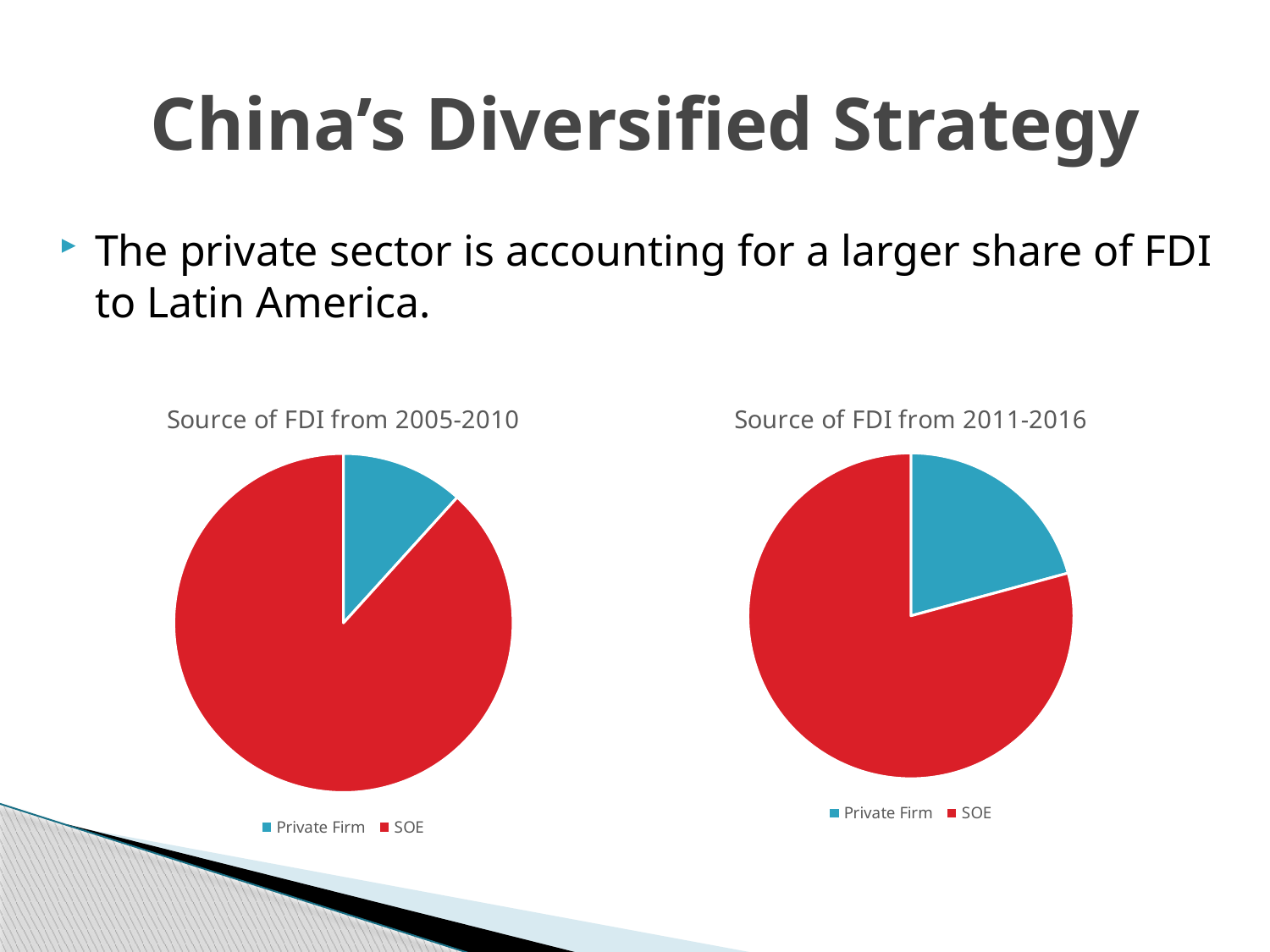
In the "Source of FDI from 2005-2010" chart, which category has the largest slice? SOE How many categories does the "Source of FDI from 2005-2010" pie chart show? 2 In the "Source of FDI from 2005-2010" chart, which category has the smallest slice? Private Firm What kind of chart is the "Source of FDI from 2005-2010" chart? Pie chart What kind of chart is the "Source of FDI from 2011-2016" chart? Pie chart In the "Source of FDI from 2011-2016" chart, what colour represents SOE? Red What is the title of the pie chart on the left of the slide? Source of FDI from 2005-2010 How many entries does the legend of the "Source of FDI from 2011-2016" chart list? 2 In the "Source of FDI from 2011-2016" chart, which category has the largest slice? SOE Which chart shows a larger Private Firm slice: the 2005-2010 chart or the 2011-2016 chart? The 2011-2016 chart In the "Source of FDI from 2011-2016" chart, which is larger: the Private Firm slice or the SOE slice? SOE In the "Source of FDI from 2011-2016" chart, which category has the smallest slice? Private Firm